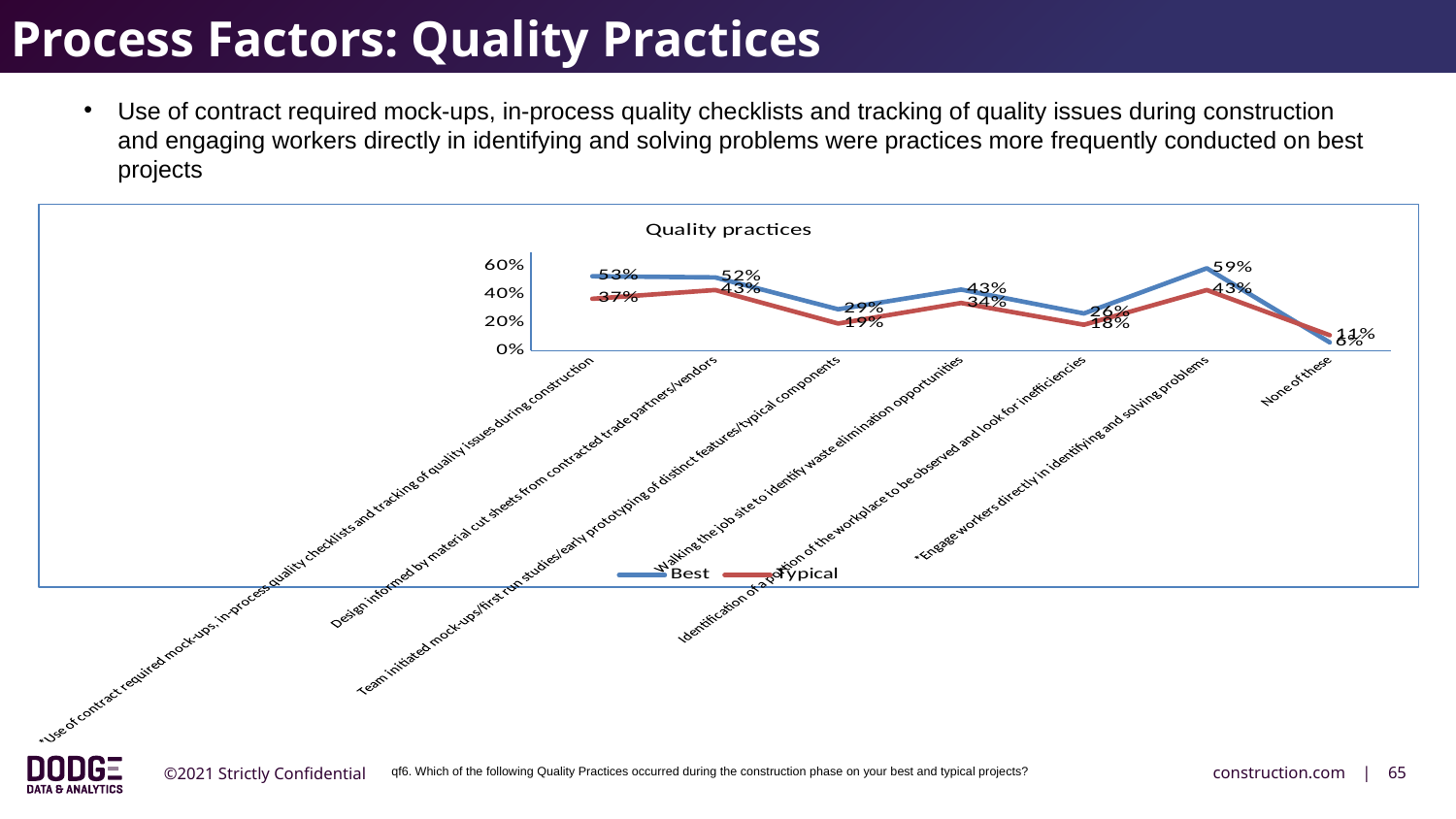
Which category has the highest Best value? Engage workers directly in identifying and solving problems What is the Typical value for 'Team initiated mock-ups/first run studies/early prototyping of distinct features/typical components'? 19% What kind of chart is shown on the slide? Line chart How many categories are plotted along the x axis of the Quality practices chart? 7 How many series does the legend of the Quality practices chart list? 2 What is the difference between the Best and Typical values for 'Design informed by material cut sheets from contracted trade partners/vendors'? 9 percentage points Which is larger for 'Identification of a portion of the workplace to be observed and look for inefficiencies': the Best value or the Typical value? Best What is the Typical value for 'Use of contract required mock-ups, in-process quality checklists and tracking of quality issues during construction'? 37% What is the Best value for 'Engage workers directly in identifying and solving problems'? 59% What is the Best value for 'Walking the job site to identify waste elimination opportunities'? 43% What is the title of the chart? Quality practices Which category has the lowest Typical value? None of these